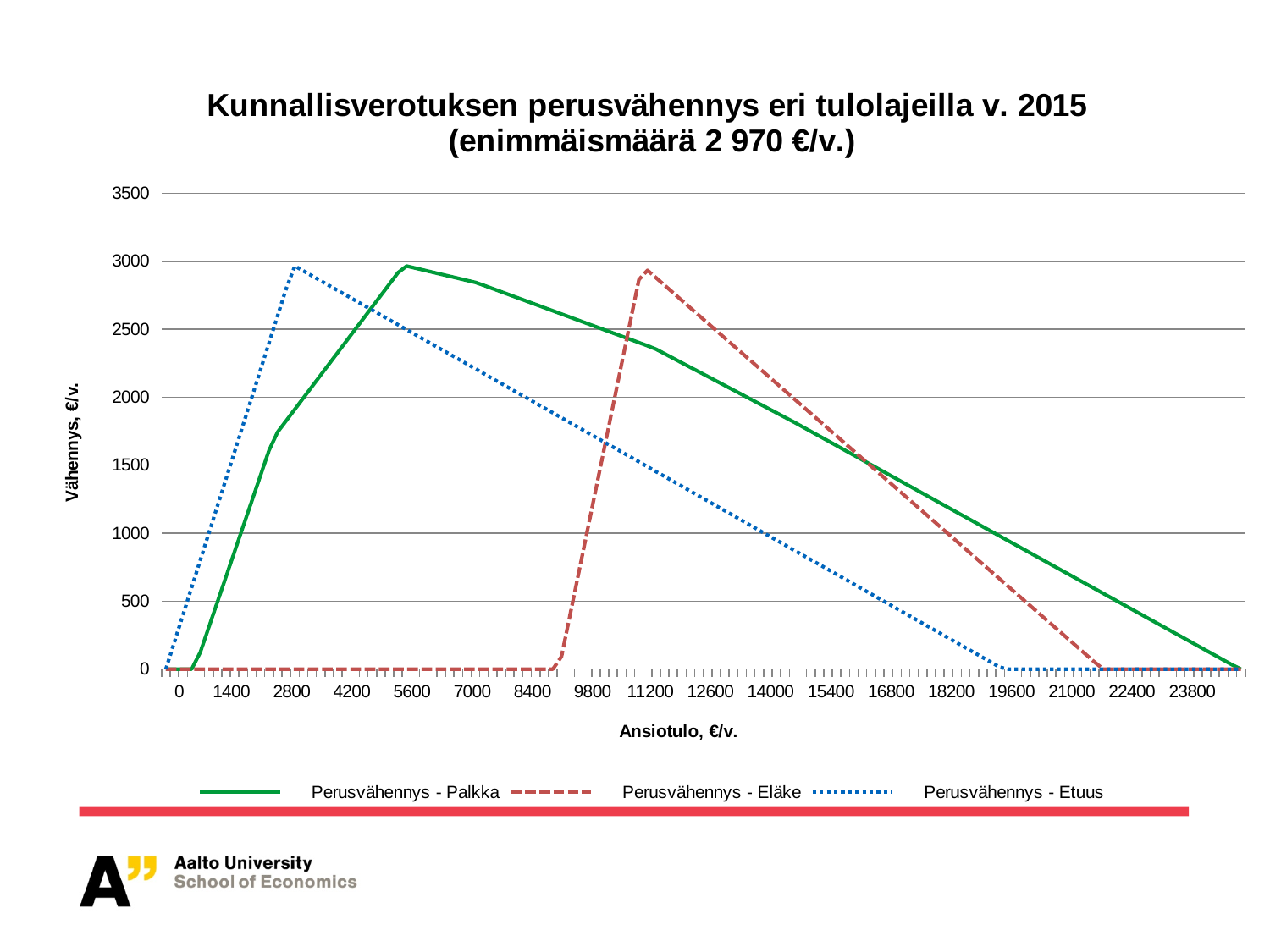
Is the value of Perusvähennys - Etuus at an income of 2800 greater or less than 2500? greater Which series is drawn with a dotted blue line? Perusvähennys - Etuus Is the value of Perusvähennys - Etuus at an income of 9800 greater or less than 1500? greater Does the Perusvähennys - Etuus line rise or fall between incomes of 2800 and 19600? fall What kind of chart is shown on the slide? line chart What is the title of the chart? Kunnallisverotuksen perusvähennys eri tulolajeilla v. 2015 (enimmäismäärä 2 970 €/v.) Is the value of Perusvähennys - Palkka at an income of 21000 greater or less than 1000? less At an income of 14000, which series has the larger value: Perusvähennys - Palkka or Perusvähennys - Etuus? Perusvähennys - Palkka At an income of 7000, which series has the larger value: Perusvähennys - Palkka or Perusvähennys - Eläke? Perusvähennys - Palkka How many series does the legend list? 3